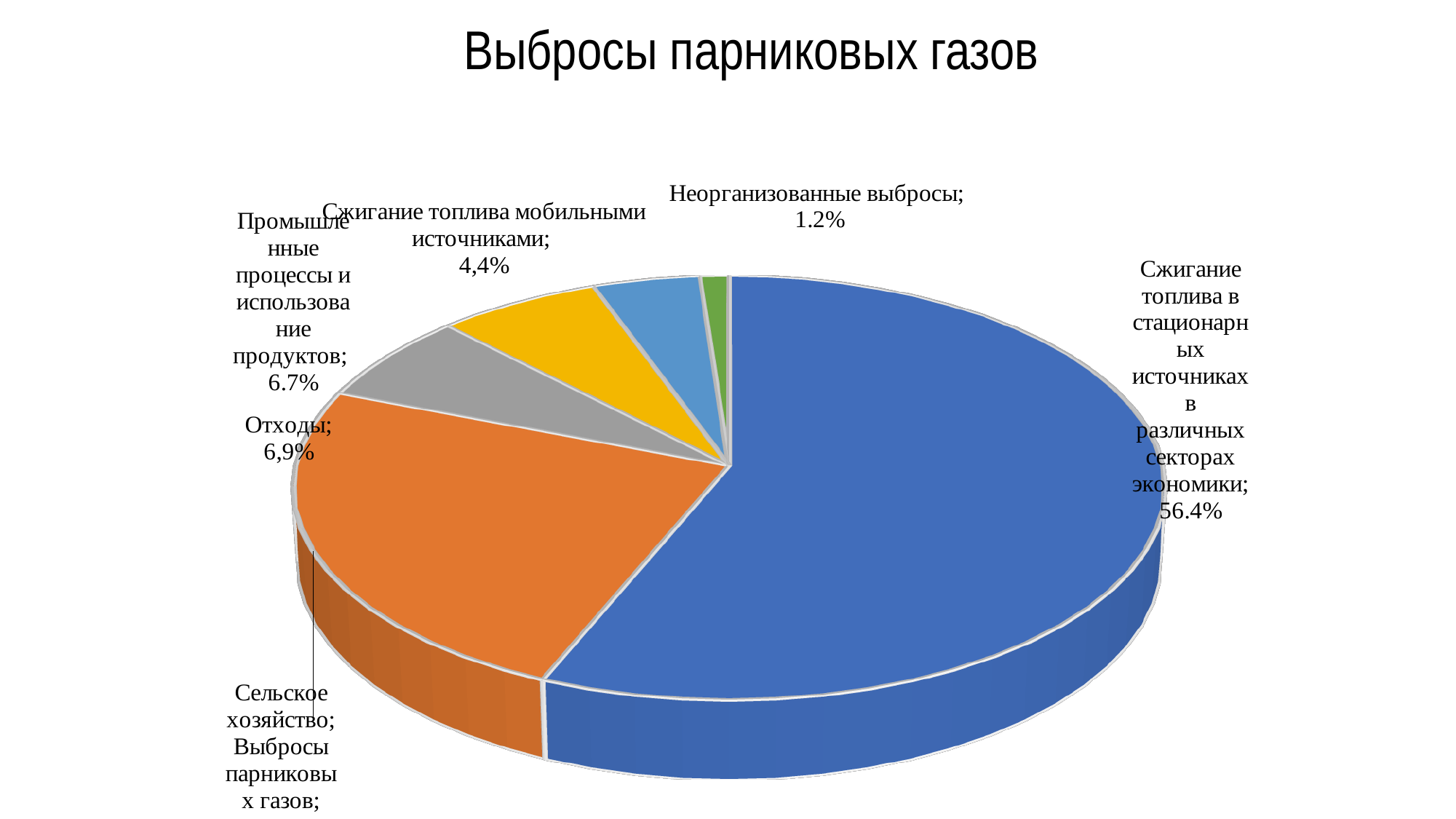
What share of the pie is labelled for "Сжигание топлива в стационарных источниках в различных секторах экономики"? 56.4% What value is shown for "Промышленные процессы и использование продуктов"? 6.7% What value is shown for "Сжигание топлива мобильными источниками"? 4,4% Which category has the smallest slice of the pie? Неорганизованные выбросы What value is shown for "Неорганизованные выбросы"? 1.2% How many slices does the pie chart have? 6 What is the title of the chart? Выбросы парниковых газов What is the difference in percentage points between "Сжигание топлива в стационарных источниках в различных секторах экономики" and "Неорганизованные выбросы"? 55.2% What kind of chart is shown on the slide? pie chart What colour is the largest slice of the pie? blue Which category has the largest slice of the pie? Сжигание топлива в стационарных источниках в различных секторах экономики What value is shown for "Отходы"? 6,9%